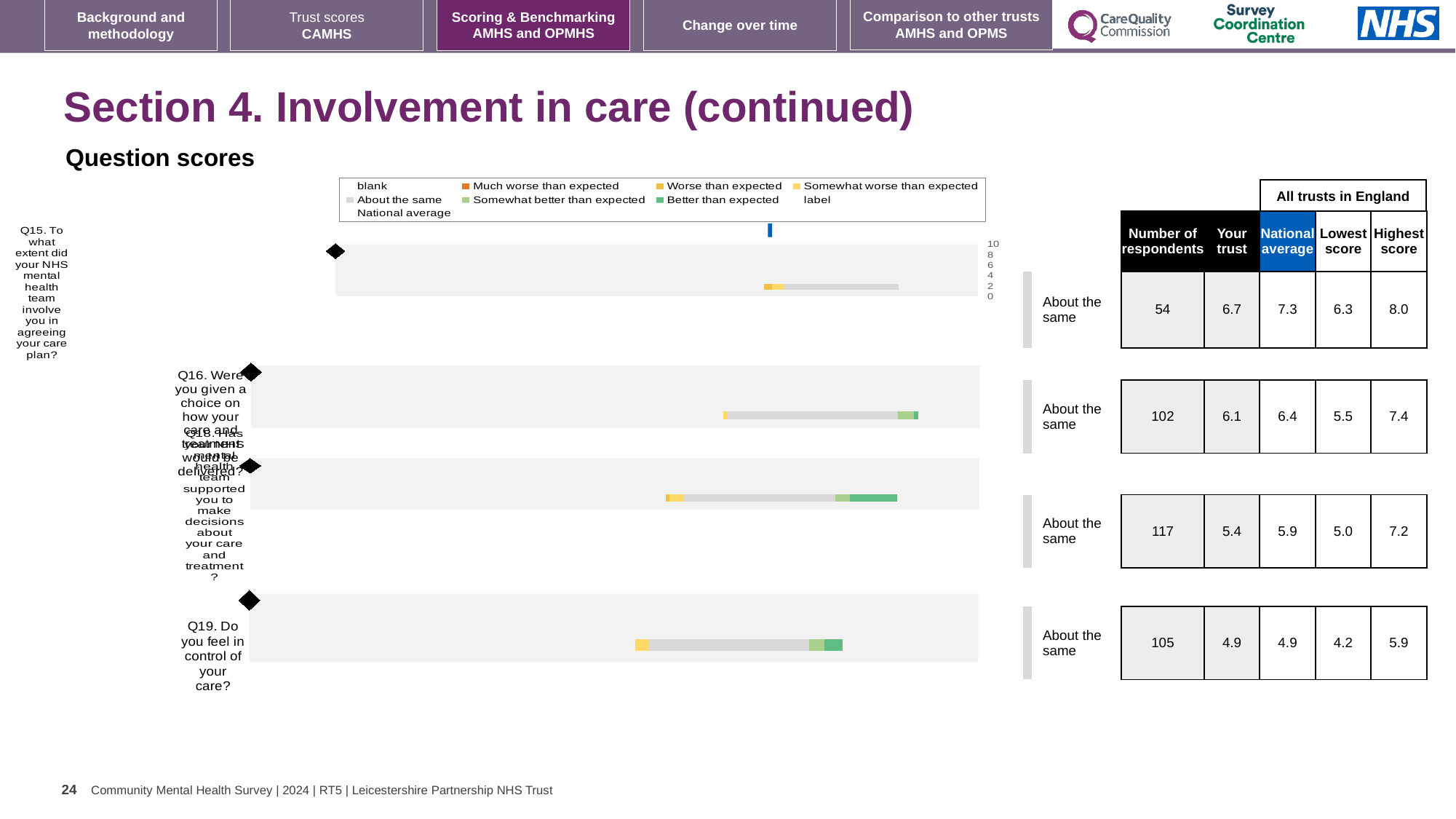
What is the 'Your trust' score for Q19 (Do you feel in control of your care?)? 4.9 For Q16, which is larger: the 'Your trust' score or the national average? National average What kind of chart is used to show the question scores on this slide? bar chart How many respondents are listed for Q16 (Were you given a choice on how your care and treatment would be delivered?)? 102 How many respondents are listed for Q18 (Has your mental health team supported you to make decisions about your care and treatment?)? 117 For Q18, what is the difference between the national average and the 'Your trust' score? 0.5 What is the highest score among all trusts in England for Q15? 8.0 Which question has the highest 'Your trust' score? Q15 How many questions are plotted in the question scores chart? 4 Which question has the lowest 'Your trust' score? Q19 What is the lowest score among all trusts in England for Q19? 4.2 What benchmark category label is shown next to each of the four questions? About the same